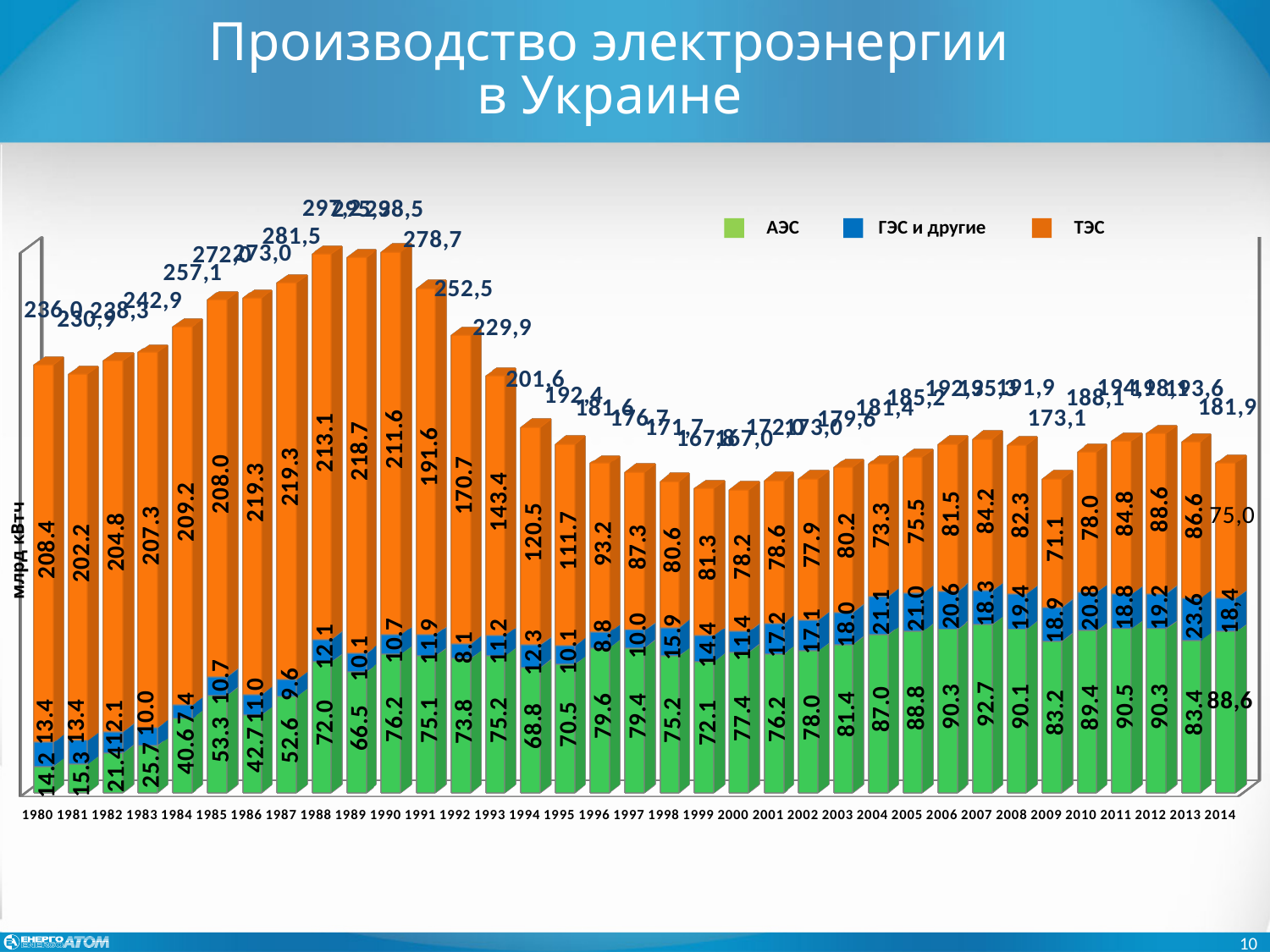
What is the value of ГЭС и другие for 2013? 23.6 In which year is the АЭС value the highest? 2007 Does the ТЭС value rise or fall from 1990 to 1999? fall Which year has the larger АЭС value, 1988 or 1989? 1988 What kind of chart is shown on the slide? stacked bar chart How many series does the legend list? 3 What is the ТЭС value for 1990? 211.6 What is the total electricity production shown for 1987? 281,5 In which year is the ТЭС value the lowest? 2009 What is the difference between the ТЭС value in 1980 and the ТЭС value in 2014? 133.4 What is the АЭС value for 2007? 92.7 How many years are shown on the x axis? 35